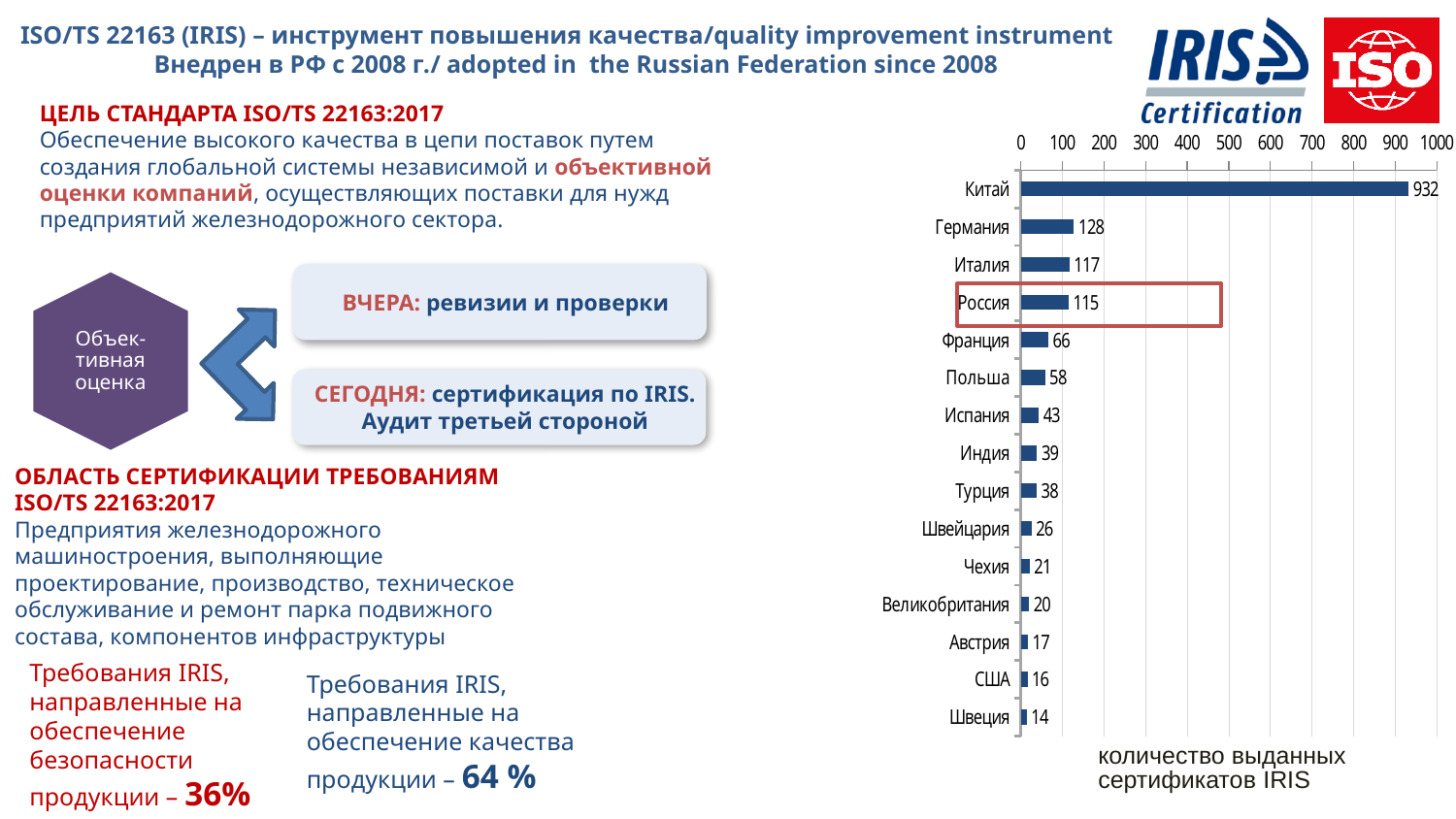
What is the value shown for Польша (Poland) in the chart? 58 What is the difference between the values for Германия and Россия in the chart? 13 Is the value for Китай greater or less than 900? greater What is the difference between the values for Китай and Германия in the chart? 804 Which country has the lowest number of issued IRIS certificates in the chart? Швеция How many countries are shown in the chart? 15 Which country has the highest number of issued IRIS certificates in the chart? Китай What is the caption below the chart? количество выданных сертификатов IRIS What is the value shown for Россия (Russia) in the chart? 115 How many IRIS certificates were issued in Китай (China) according to the chart? 932 What type of chart is used to show the number of issued IRIS certificates? Bar chart Which has a larger value in the chart, Франция or Испания? Франция